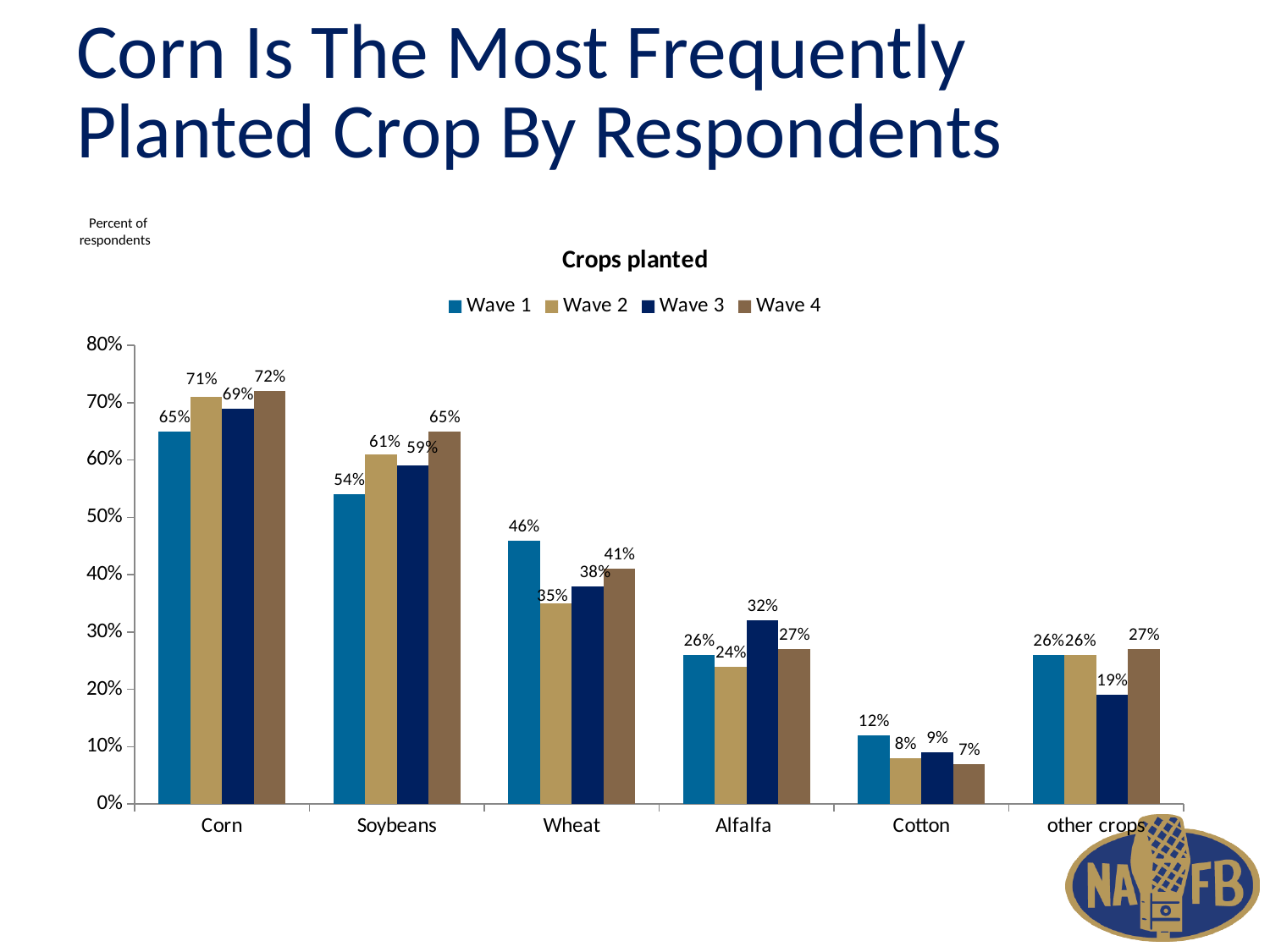
What is the title of the chart? Crops planted What is the Wave 2 value for Cotton? 8% What is the Wave 4 value for Corn? 72% Which crop has the lowest Wave 4 value? Cotton How many crop categories are shown on the x axis? 6 What is the Wave 1 value for Wheat? 46% What is the Wave 3 value for Alfalfa? 32% What kind of chart is shown on the slide? Bar chart How many series does the legend list? 4 Which is larger for Wheat: the Wave 2 value or the Wave 4 value? Wave 4 What is the difference between the Wave 4 and Wave 1 values for Soybeans? 11% Which crop has the highest Wave 1 value? Corn